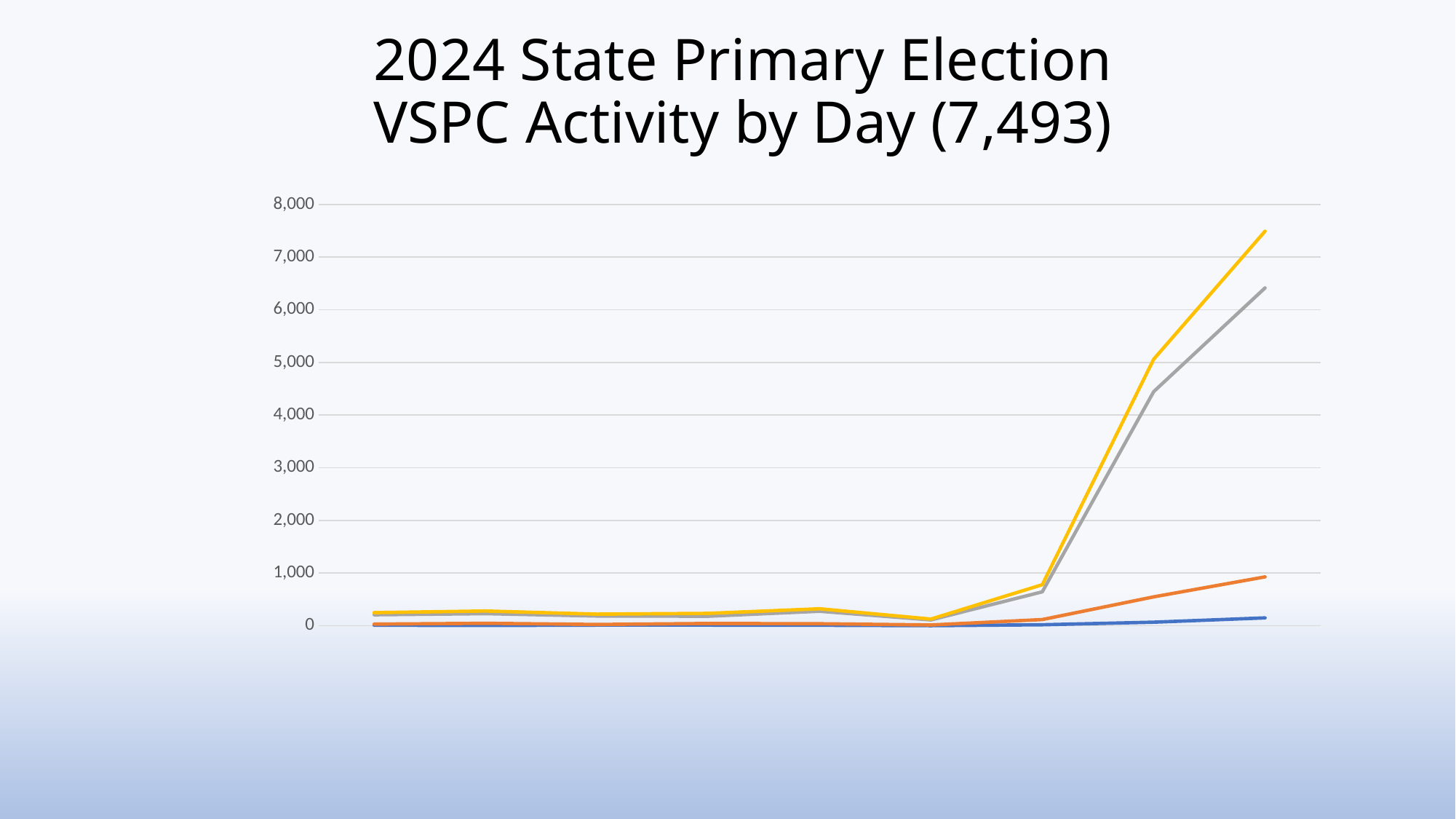
Do the yellow and gray lines rise or fall toward the right-hand end of the chart? rise What is the title of the chart on the slide? 2024 State Primary Election VSPC Activity by Day (7,493) Is the final value of the gray line greater or less than 6,000? greater Is the final value of the yellow line greater or less than 7,000? greater Is the final value of the gray line greater or less than 7,000? less Which coloured line has the lowest value at the right-hand end of the chart? the blue line At the right-hand end of the chart, which is larger: the yellow line or the gray line? the yellow line Which coloured line reaches the highest value on the chart? the yellow line What kind of chart is shown on the slide? line chart What is the highest value labelled on the vertical axis? 8,000 How many lines are plotted on the chart? 4